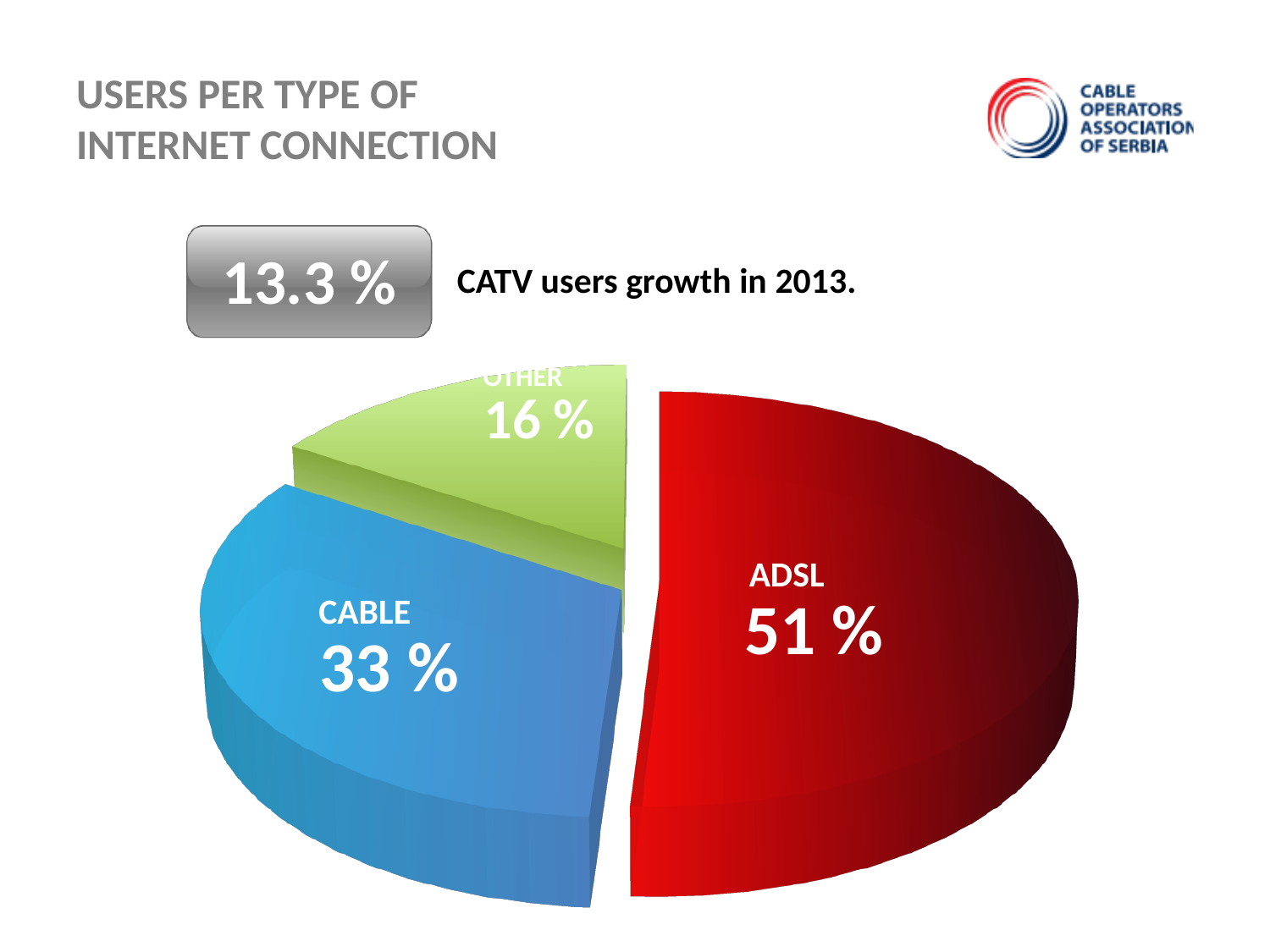
Which type of internet connection has the smallest share of users? OTHER What share of users does OTHER account for? 16 % Which has a larger share of users, CABLE or OTHER? CABLE How many slices does the pie chart have? 3 How many percentage points larger is the CABLE share than the OTHER share? 17 Which type of internet connection has the largest share of users? ADSL What type of chart is shown on the slide? pie chart What share of users does CABLE account for? 33 % How many percentage points larger is the ADSL share than the CABLE share? 18 What is the title of the chart on the slide? USERS PER TYPE OF INTERNET CONNECTION What colour is the ADSL slice? red What share of users does ADSL account for? 51 %